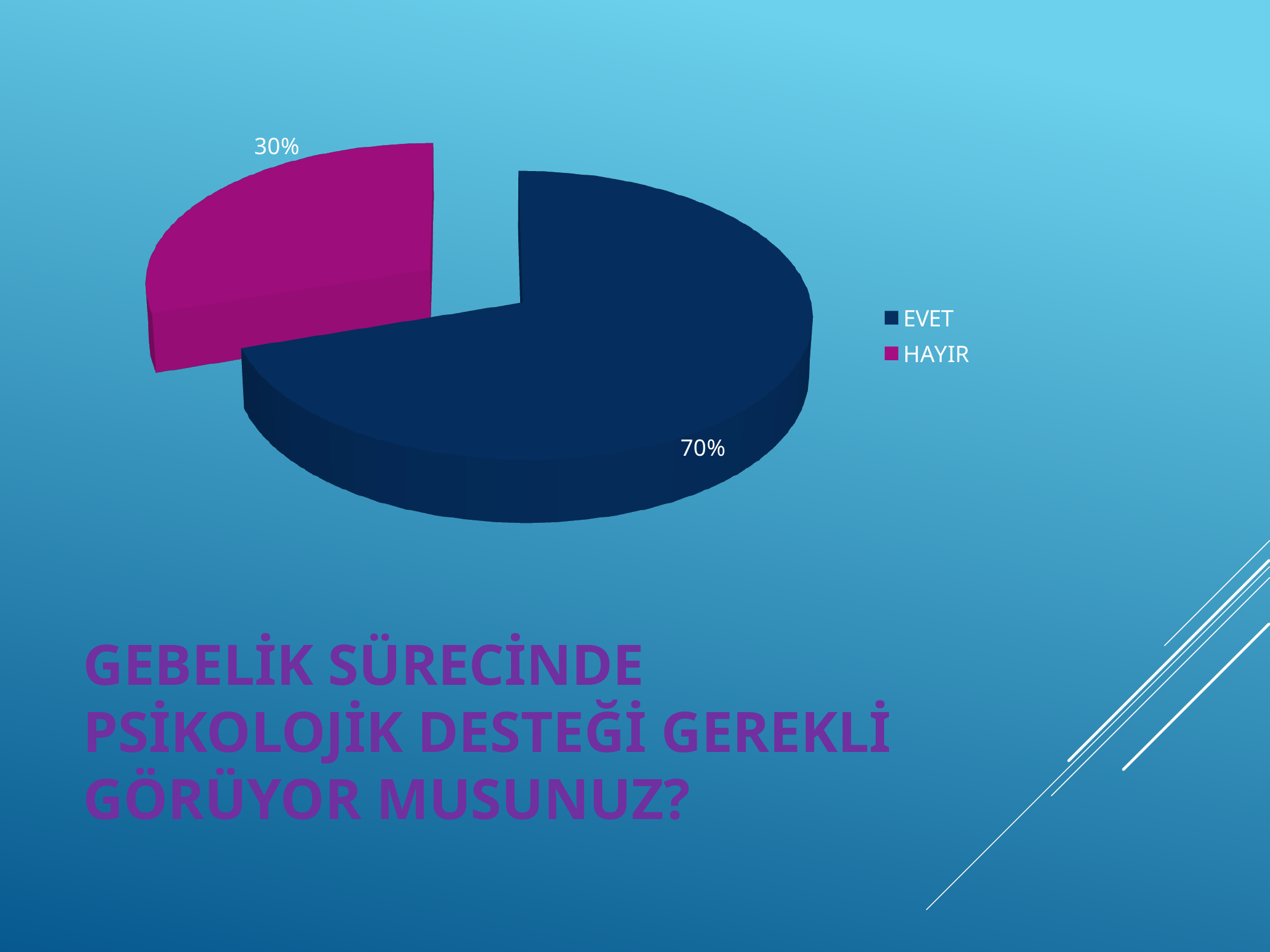
Which is larger, the EVET slice or the HAYIR slice? EVET How many categories does the pie chart show? 2 What colour is the HAYIR slice? Magenta What percentage of the pie chart is EVET? 70% What kind of chart is shown on the slide? Pie chart Which category has the smallest share of the pie chart? HAYIR Which category has the largest share of the pie chart? EVET How many entries does the legend list? 2 What share of the pie does the HAYIR slice represent? 30% What is the difference in percentage points between the EVET and HAYIR slices? 40 What colour is the EVET slice? Dark blue What percentage of the pie chart is HAYIR? 30%